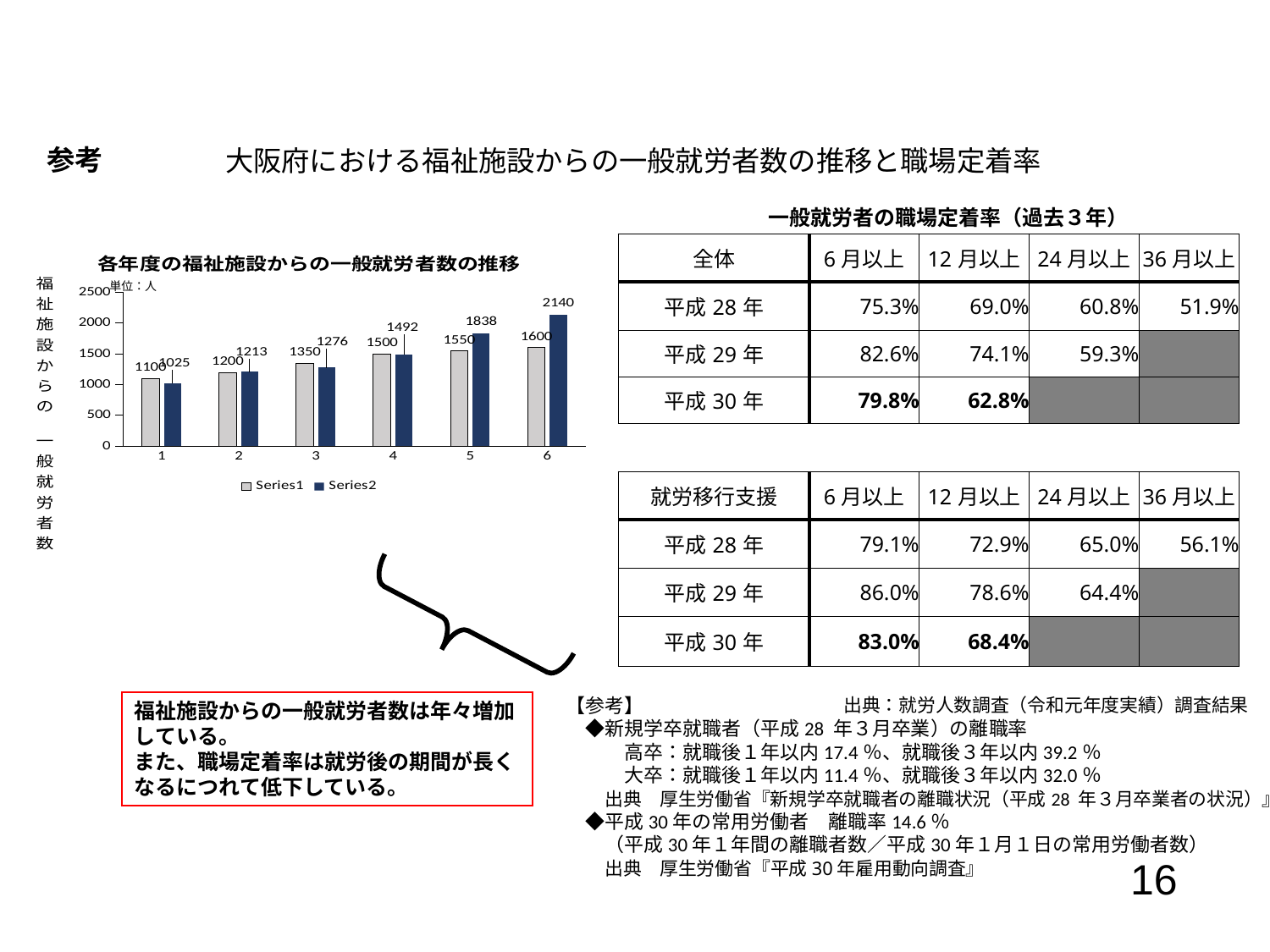
In the chart 各年度の福祉施設からの一般就労者数の推移, what is the value of Series1 for category 4? 1500 In the chart 各年度の福祉施設からの一般就労者数の推移, is the Series2 value for category 5 greater or less than 1500? greater In the chart 各年度の福祉施設からの一般就労者数の推移, do the Series1 values rise or fall from category 1 to category 6? rise How many series does the legend of the chart 各年度の福祉施設からの一般就労者数の推移 list? 2 In the chart 各年度の福祉施設からの一般就労者数の推移, for category 3, which series has the larger value, Series1 or Series2? Series1 In the chart 各年度の福祉施設からの一般就労者数の推移, what is the value of Series2 for category 6? 2140 What kind of chart is 各年度の福祉施設からの一般就労者数の推移? bar chart In the chart 各年度の福祉施設からの一般就労者数の推移, what is the value of Series2 for category 5? 1838 How many categories are shown on the x axis of the chart 各年度の福祉施設からの一般就労者数の推移? 6 In the chart 各年度の福祉施設からの一般就労者数の推移, which category has the highest Series2 value? 6 In the chart 各年度の福祉施設からの一般就労者数の推移, what is the difference between Series2 and Series1 for category 6? 540 In the chart 各年度の福祉施設からの一般就労者数の推移, which category has the lowest Series2 value? 1